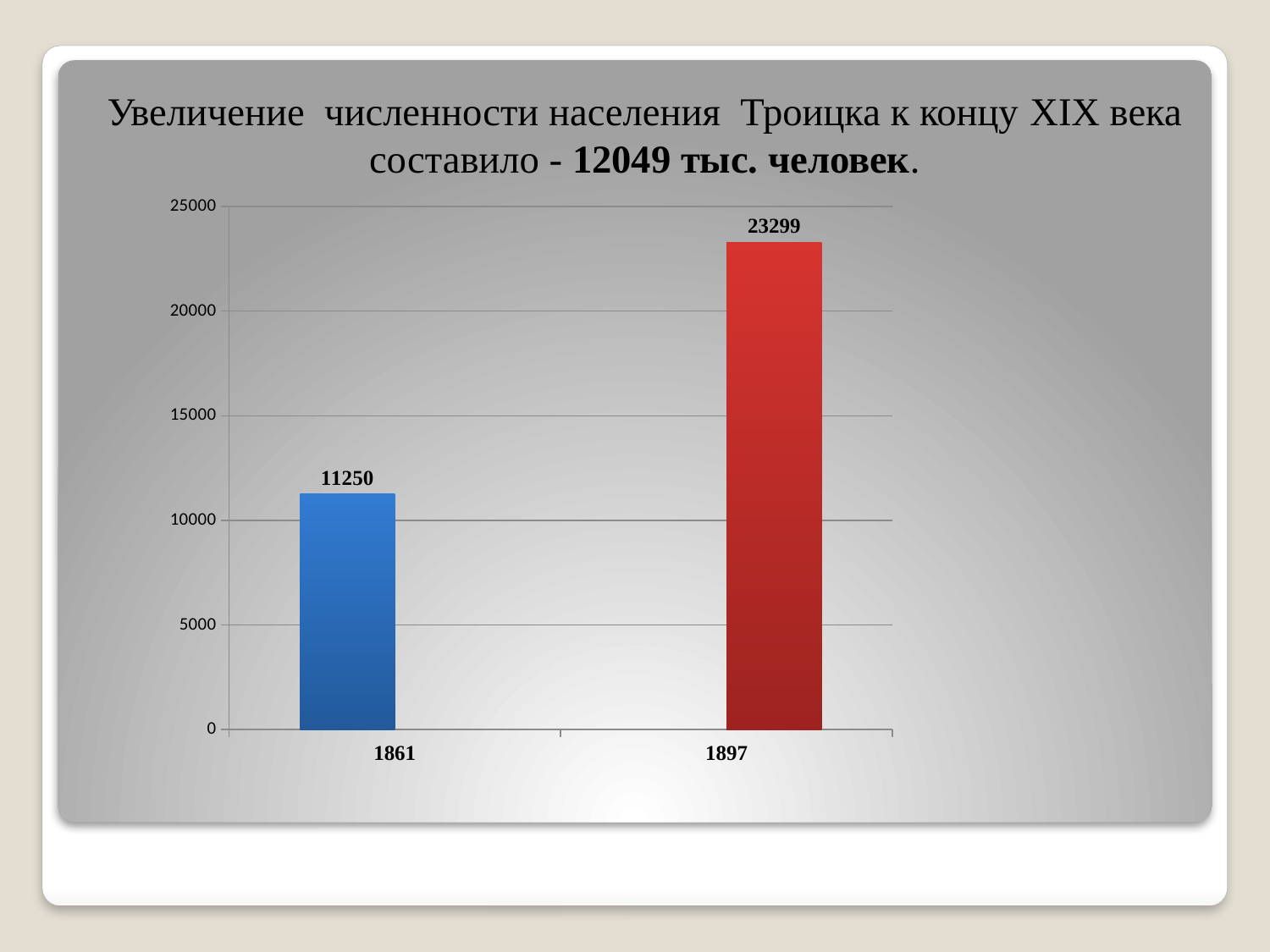
What is the value for 1897? 23299 How many categories are shown on the x axis? 2 Is the value for 1861 greater or less than 10000? greater What is the difference between the values for 1897 and 1861? 12049 What colour is the bar for 1897? red Do the values rise or fall from 1861 to 1897? rise What kind of chart is shown on the slide? bar chart Which category has the lowest value? 1861 What is the value for 1861? 11250 Which category has the highest value? 1897 Is the value for 1897 greater or less than 25000? less Which is larger, the value for 1861 or the value for 1897? 1897